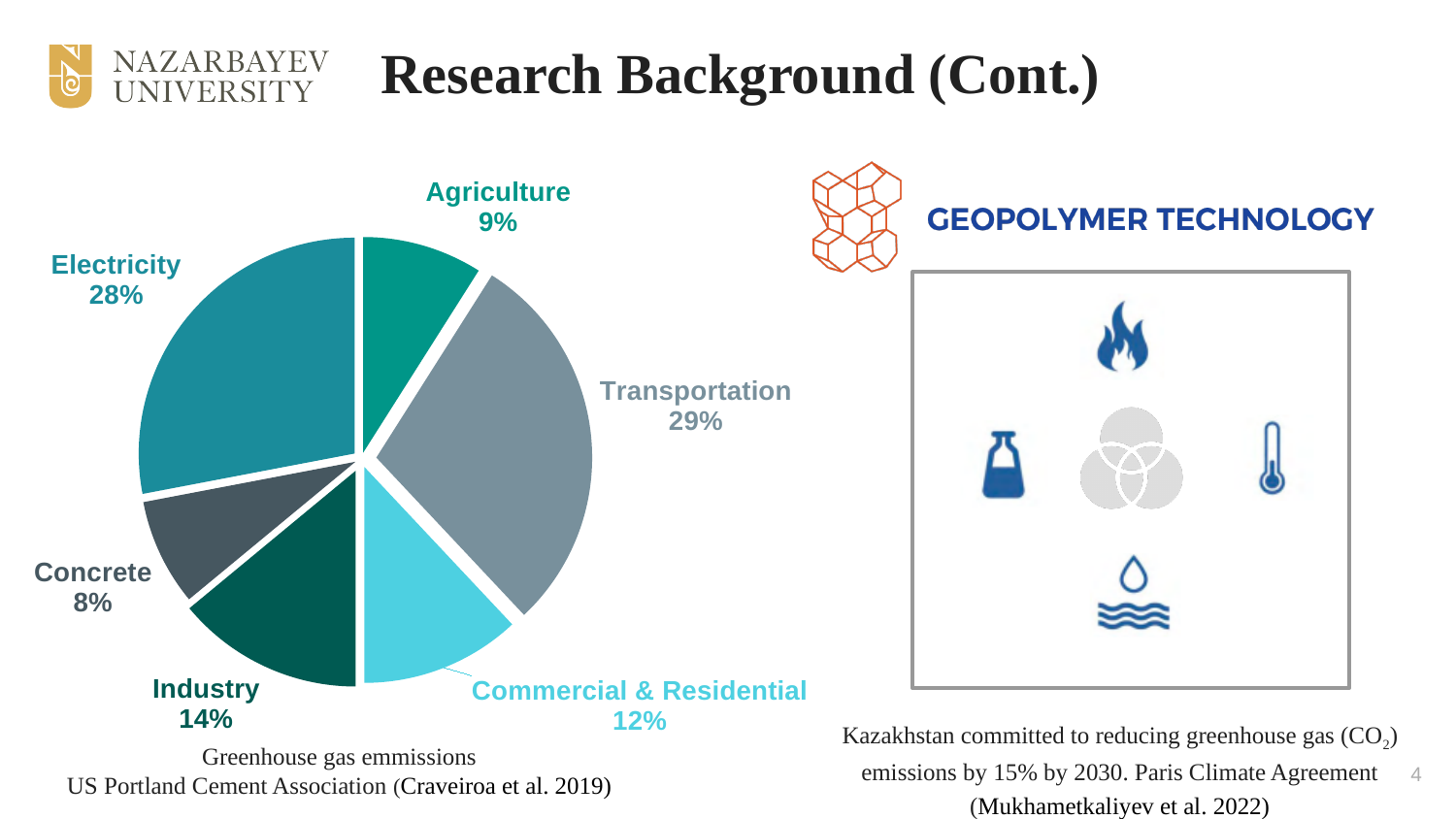
What percentage is shown for Concrete in the pie chart? 8% How many slices does the pie chart have? 6 What is the difference in percentage points between Industry and Agriculture in the pie chart? 5 What kind of chart is shown on the slide? pie chart What is the combined share of Electricity and Transportation in the pie chart? 57% What does the caption below the pie chart say the chart shows? Greenhouse gas emmissions What percentage is shown for Commercial & Residential in the pie chart? 12% What percentage is shown for Electricity in the pie chart? 28% Which is larger in the pie chart, Industry or Commercial & Residential? Industry Which category has the largest slice in the pie chart? Transportation Which category has the smallest slice in the pie chart? Concrete What share of greenhouse gas emissions does Transportation account for in the pie chart? 29%